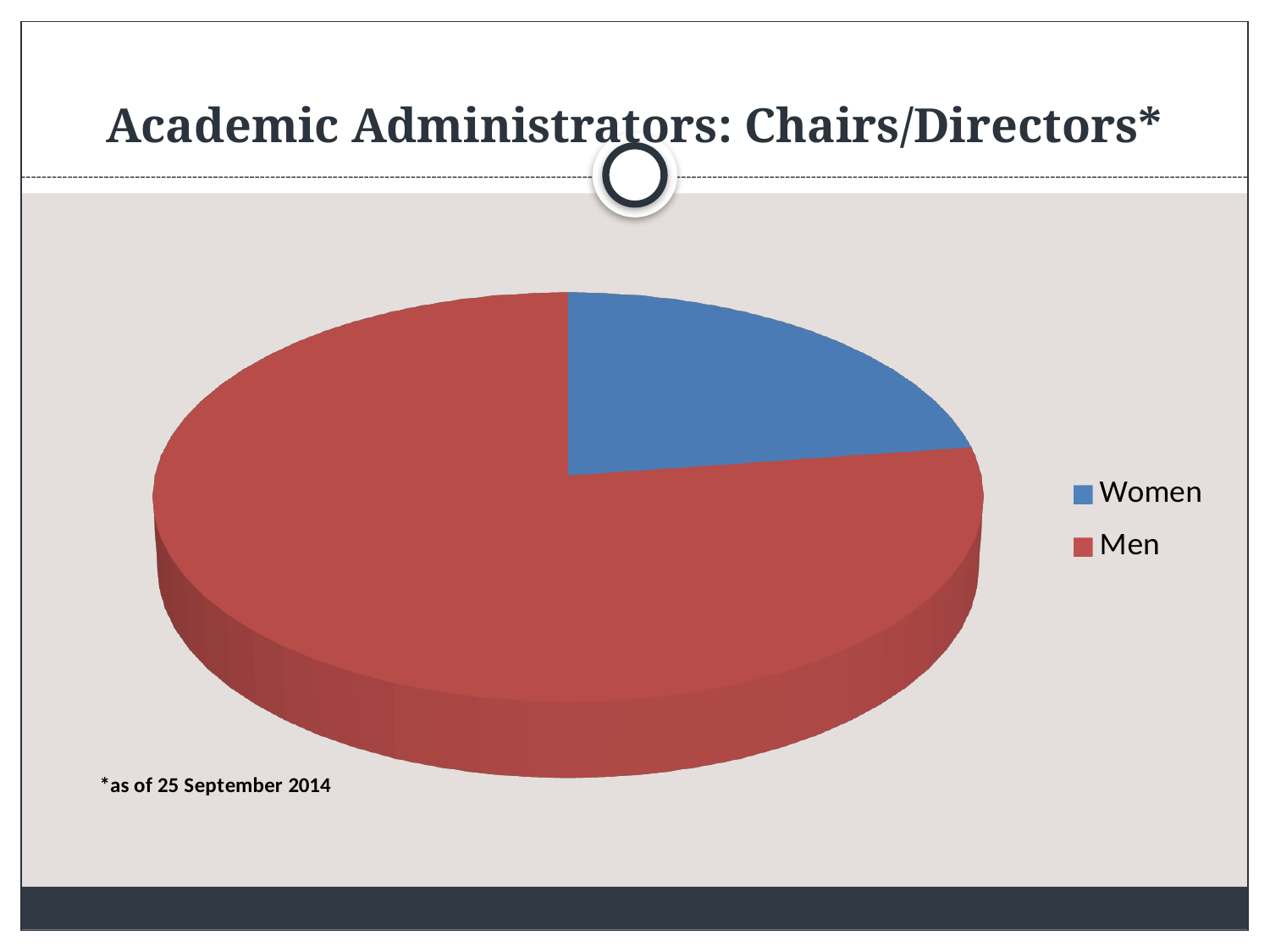
Which category has the smallest slice of the pie? Women What is the title of the chart on the slide? Academic Administrators: Chairs/Directors* What colour is the slice for Men? red What kind of chart is shown on the slide? pie chart Which slice is larger, Women or Men? Men How many slices does the pie chart have? 2 Which category has the largest slice of the pie? Men How many entries does the legend list? 2